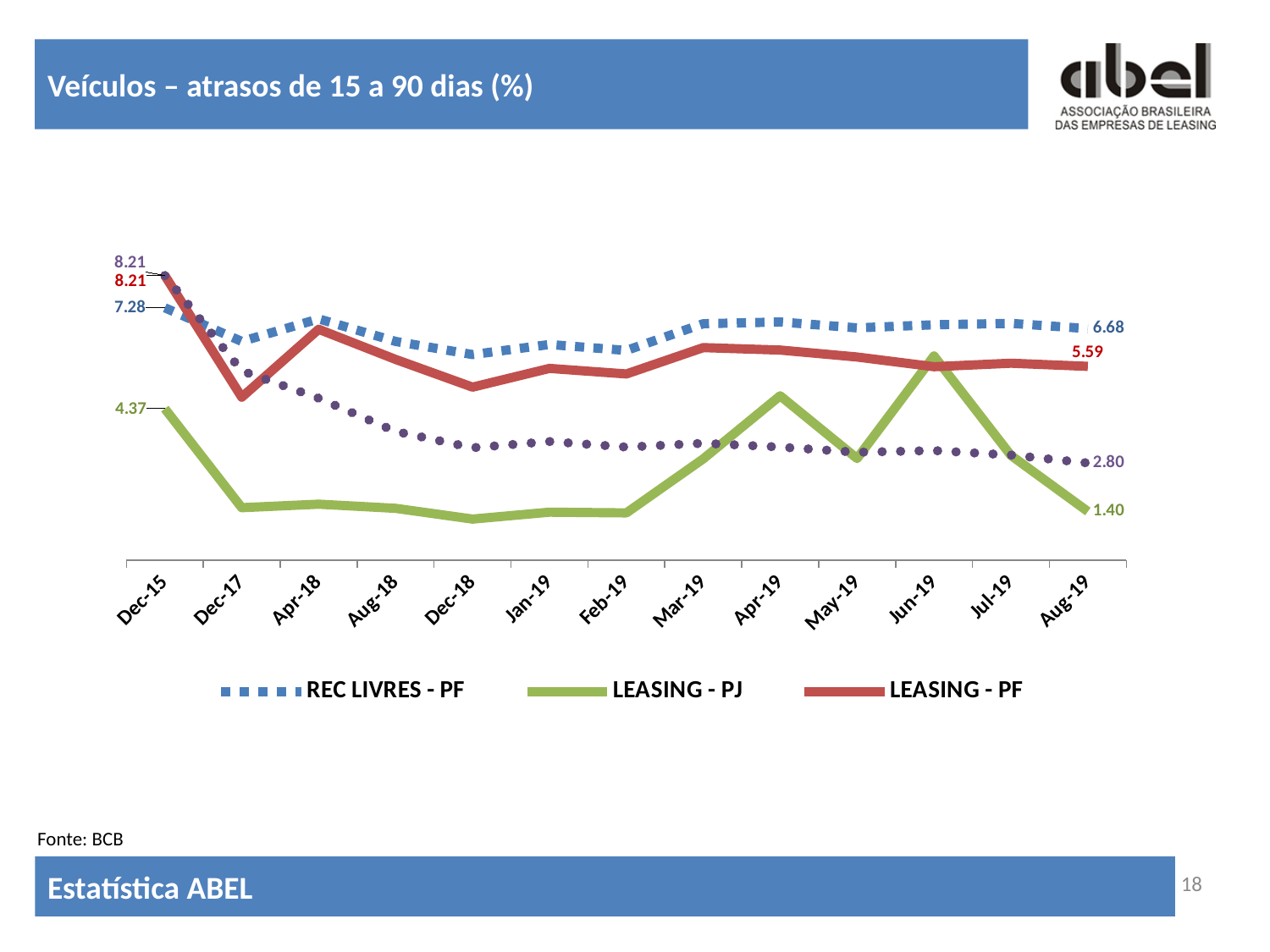
What kind of chart is shown on the slide? line chart How many dates are shown on the x axis? 13 What is the value of LEASING - PJ at Dec-15? 4.37 At Aug-19, which is larger: REC LIVRES - PF or LEASING - PF? REC LIVRES - PF What is the title of the chart? Veículos – atrasos de 15 a 90 dias (%) How many series does the legend list? 3 By how much did LEASING - PJ fall from Dec-15 to Aug-19? 2.97 What is the value of LEASING - PJ at Aug-19? 1.40 What is the value of LEASING - PF at Aug-19? 5.59 What is the difference between LEASING - PF at Dec-15 (8.21) and at Aug-19 (5.59)? 2.62 What is the value of REC LIVRES - PF at Aug-19? 6.68 What is the value of REC LIVRES - PF at Dec-15? 7.28